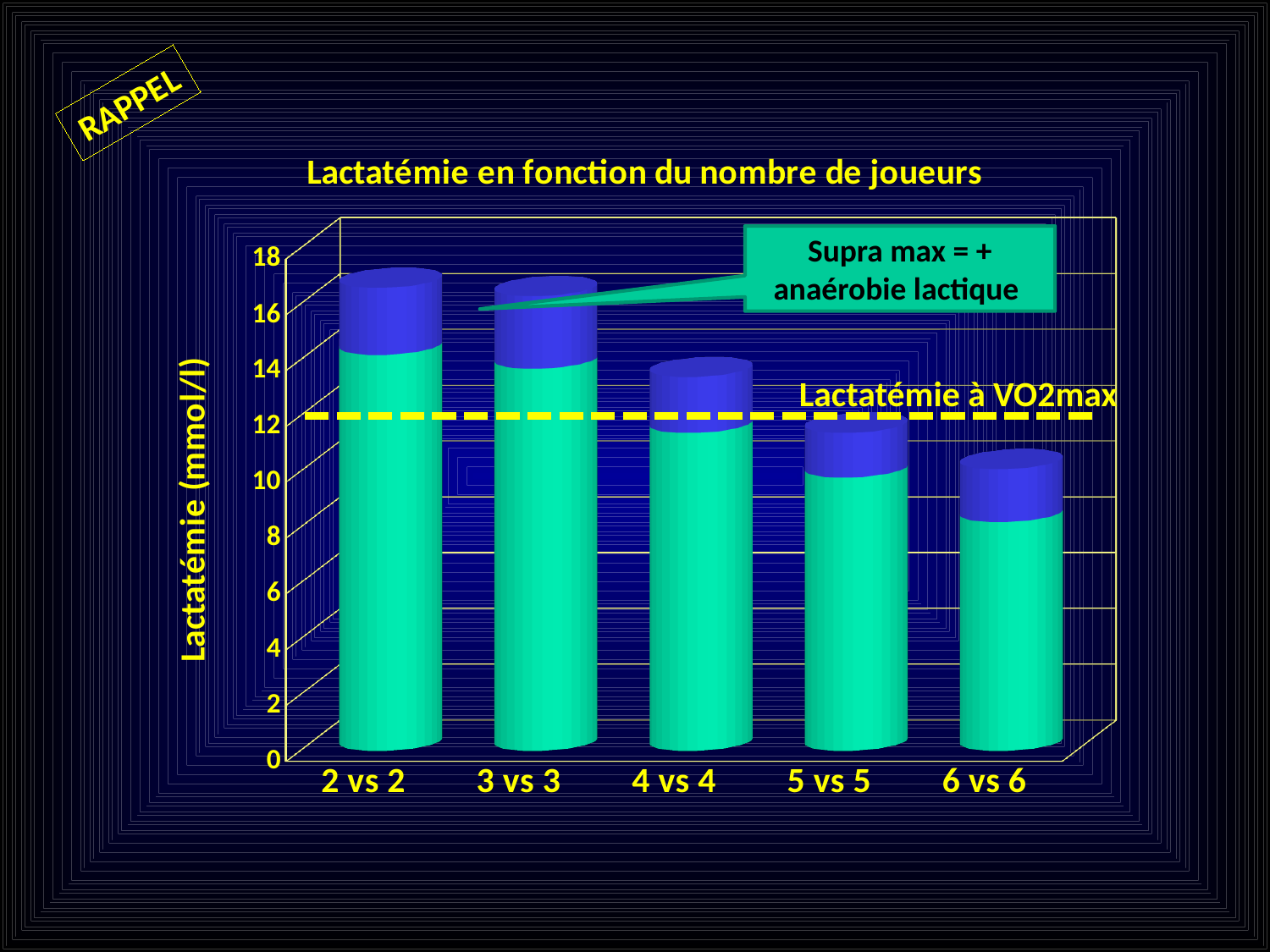
Is the value for 6 vs 6 greater or less than 12? less Do the values rise or fall as the number of players increases from 2 vs 2 to 6 vs 6? Fall What type of chart is shown on the slide? Bar chart Which is larger, the value for 3 vs 3 or the value for 5 vs 5? 3 vs 3 Which category has the lowest lactatémie value? 6 vs 6 Is the value for 2 vs 2 greater or less than 16? greater Is the value for 4 vs 4 greater or less than 12? greater Which is larger, the value for 2 vs 2 or the value for 6 vs 6? 2 vs 2 Which category has the highest lactatémie value? 2 vs 2 How many categories are plotted on the x axis? 5 What is the label of the vertical axis? Lactatémie (mmol/l) What is the title of the chart? Lactatémie en fonction du nombre de joueurs